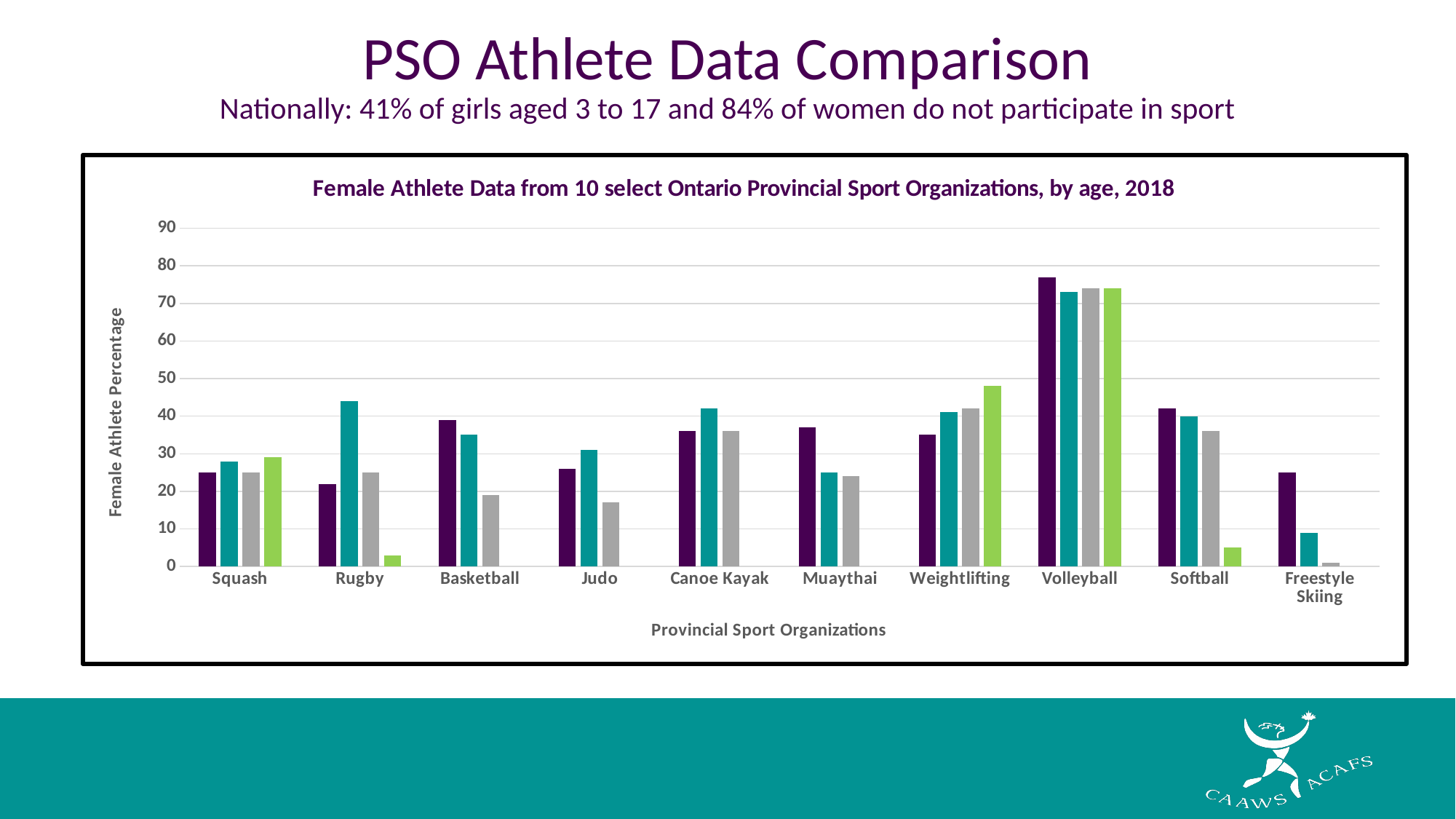
Is the tallest bar for Volleyball greater or less than 70? greater Which sport has higher bars overall, Volleyball or Squash? Volleyball Which sport has the tallest bars in the chart? Volleyball What is the label of the vertical axis? Female Athlete Percentage What is the title of the chart? Female Athlete Data from 10 select Ontario Provincial Sport Organizations, by age, 2018 How many bars are shown for Squash? 4 Is the tallest bar for Rugby greater or less than 40? greater Is the tallest bar for Freestyle Skiing greater or less than 30? less What kind of chart is shown on the slide? bar chart Which sport has the lowest bars overall in the chart? Freestyle Skiing How many provincial sport organizations are shown on the x axis? 10